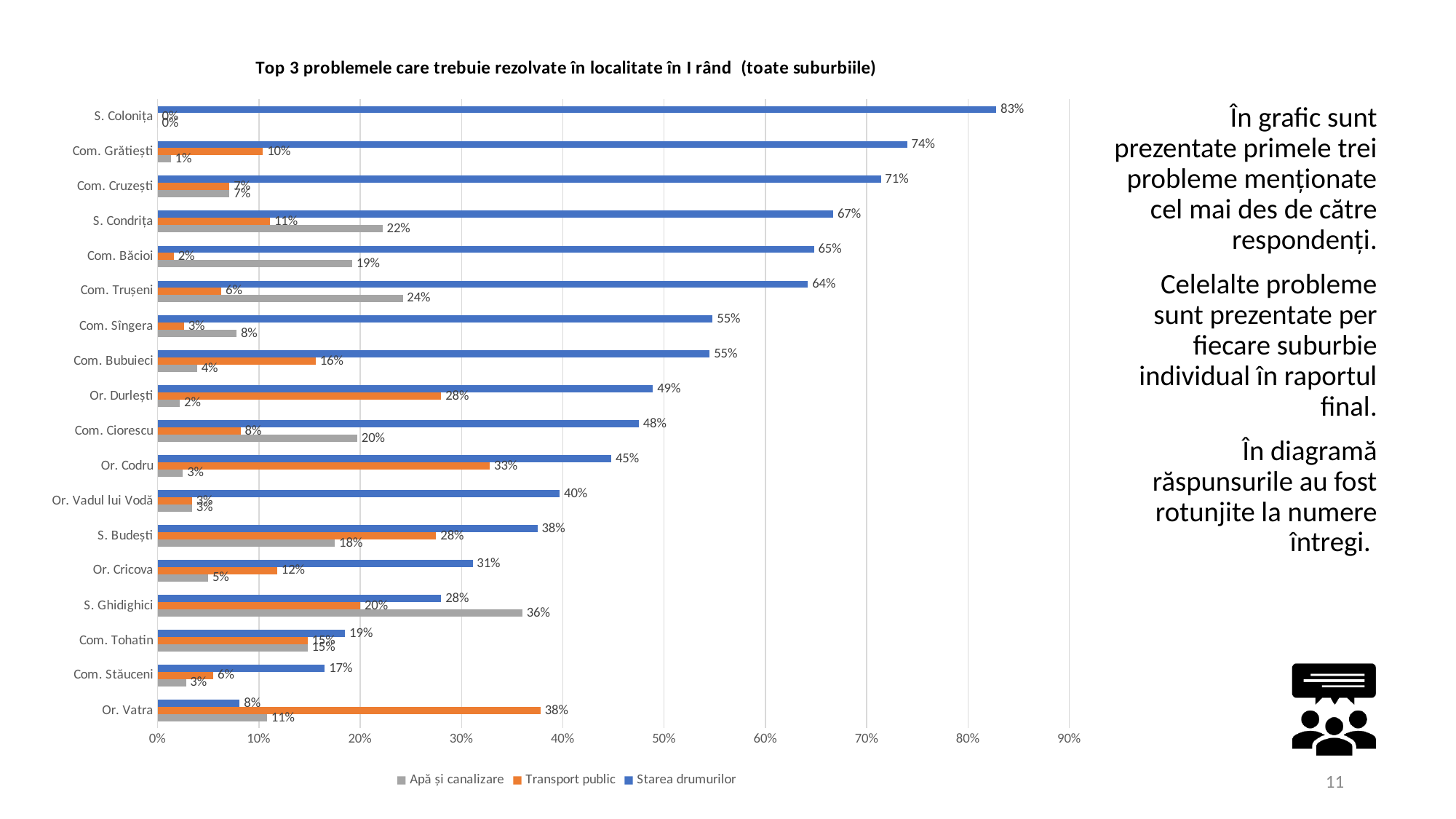
Which locality has the highest value for Transport public? Or. Vatra What is the value of Transport public for Or. Codru? 33% Which series is shown in orange in the legend? Transport public Which locality has the highest value for Starea drumurilor? S. Colonița What is the value of Starea drumurilor for S. Colonița? 83% What kind of chart is shown on the slide? Bar chart How many series does the legend list? 3 Which has the larger Transport public value, Or. Durlești or Com. Bubuieci? Or. Durlești Which locality has the lowest value for Starea drumurilor? Or. Vatra How many localities are shown on the chart? 18 What is the value of Apă și canalizare for S. Ghidighici? 36% What is the difference between the Starea drumurilor values for S. Colonița and Com. Grătiești? 9 percentage points